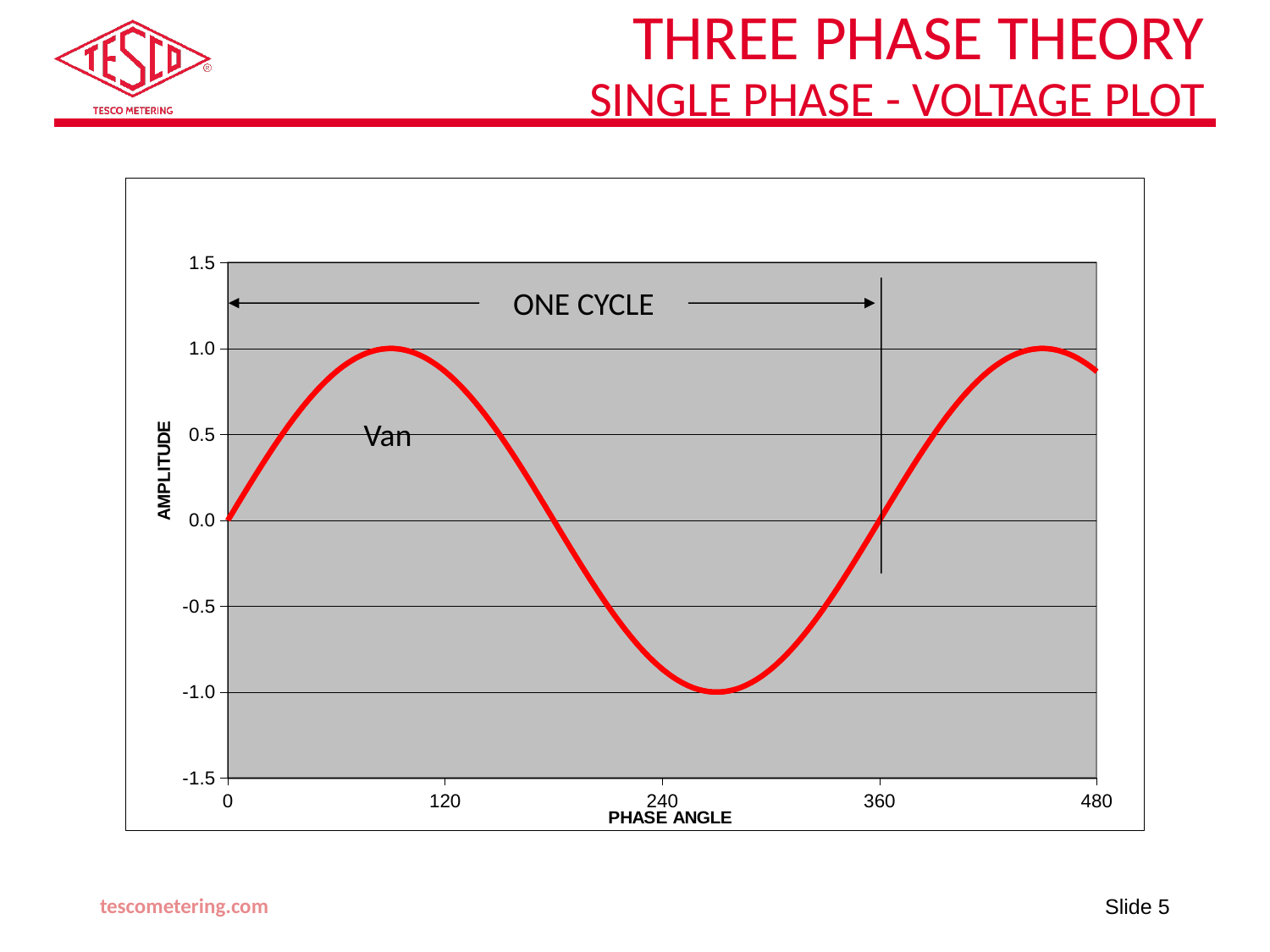
What is the amplitude of Van at a phase angle of 0? 0.0 What is the lowest amplitude reached by the Van curve? -1.0 What is the name of the plotted series? Van Does the Van curve rise or fall between phase angles 120 and 240? fall What kind of chart is shown on the slide? line chart What is the amplitude of Van at a phase angle of 360? 0.0 How many tick labels are shown on the phase angle axis? 5 What is the label of the x axis? PHASE ANGLE What is the highest amplitude reached by the Van curve? 1.0 What is the label of the y axis? AMPLITUDE Is the amplitude of Van at a phase angle of 120 greater or less than 0.5? greater Is the amplitude of Van at a phase angle of 240 greater or less than -0.5? less